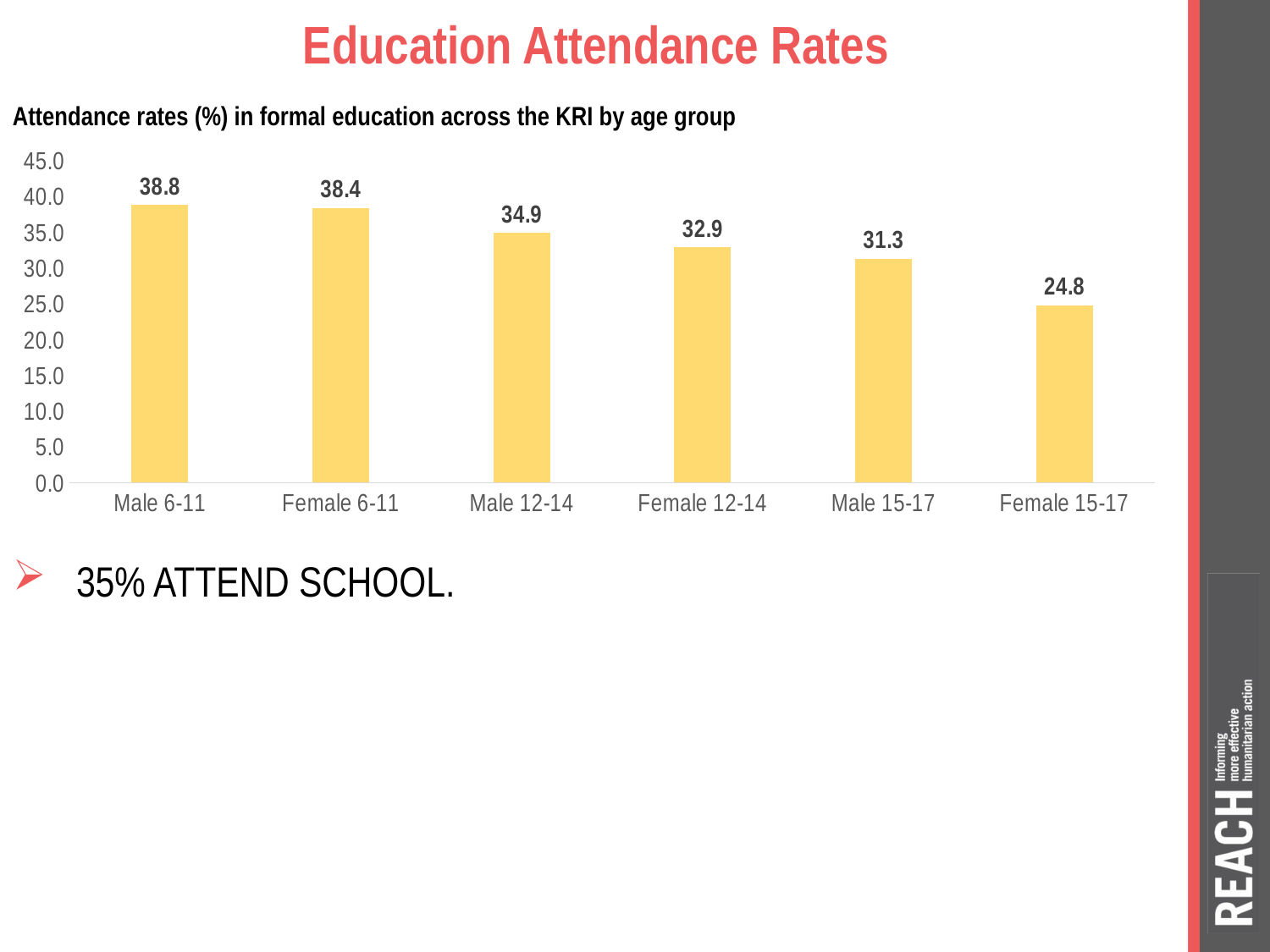
Which category has the highest attendance rate? Male 6-11 What is the attendance rate for Male 12-14? 34.9 What kind of chart is shown on the slide? Bar chart What is the title of the chart? Attendance rates (%) in formal education across the KRI by age group What is the attendance rate for Female 15-17? 24.8 How many categories are shown on the x axis? 6 What is the difference between the attendance rates for Male 15-17 and Female 15-17? 6.5 Do the attendance rates rise or fall moving from left to right along the x axis? Fall Is the value for Female 12-14 greater or less than 30.0? greater Which is larger, the attendance rate for Female 12-14 or Male 15-17? Female 12-14 Which category has the lowest attendance rate? Female 15-17 What is the attendance rate for Male 6-11? 38.8